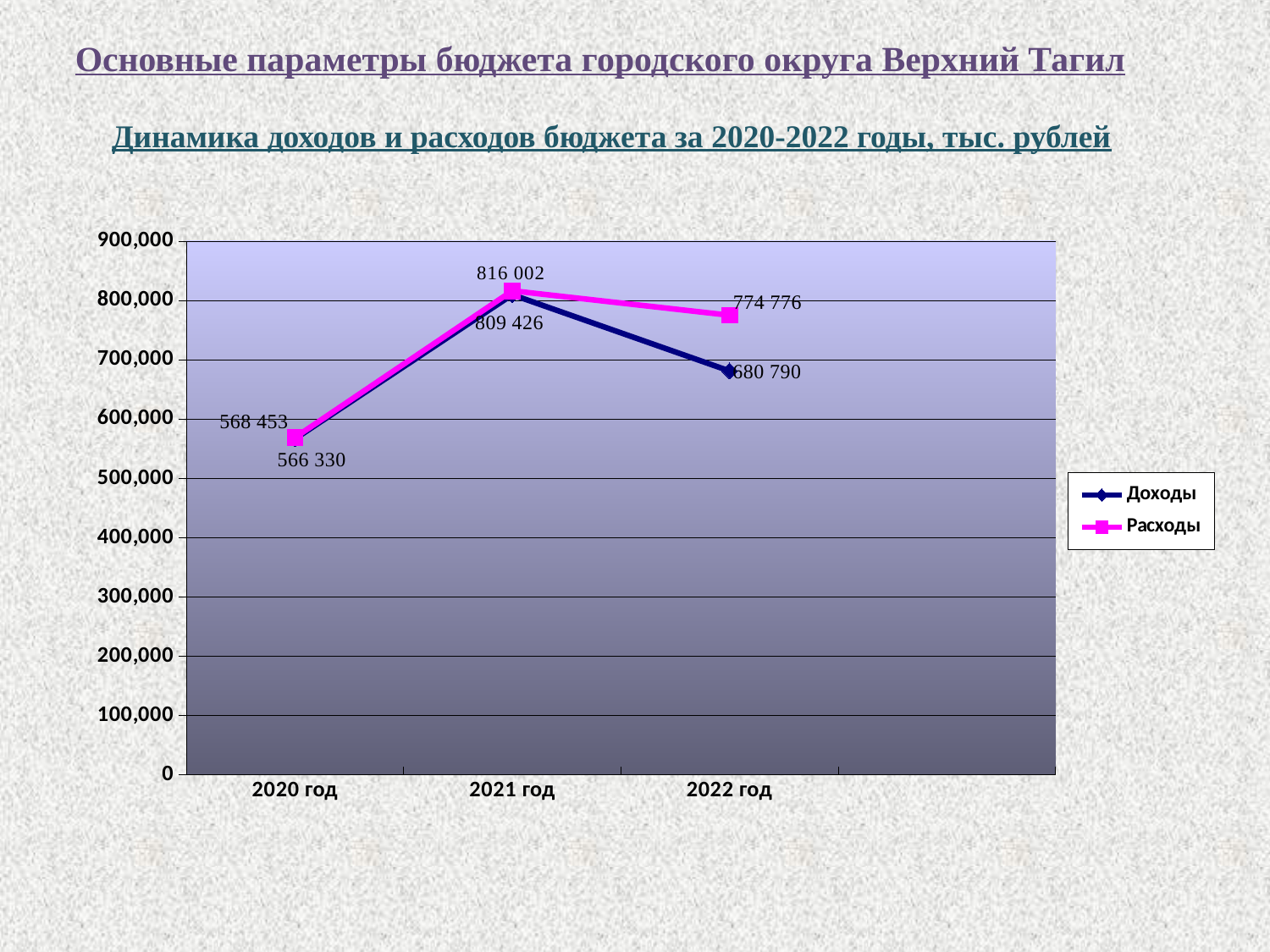
In which year is Расходы highest? 2021 год What is the value of Доходы for 2022 год? 680 790 Which is larger in 2021 год, Доходы or Расходы? Расходы What type of chart is shown on the slide? line chart How many years are plotted on the x axis? 3 Does Доходы rise or fall from 2021 год to 2022 год? fall In which year is Доходы lowest? 2020 год How many series does the legend list? 2 What is the value of Расходы for 2020 год? 568 453 What is the value of Расходы for 2022 год? 774 776 What is the value of Доходы for 2021 год? 809 426 What is the difference between Расходы and Доходы in 2022 год? 93 986